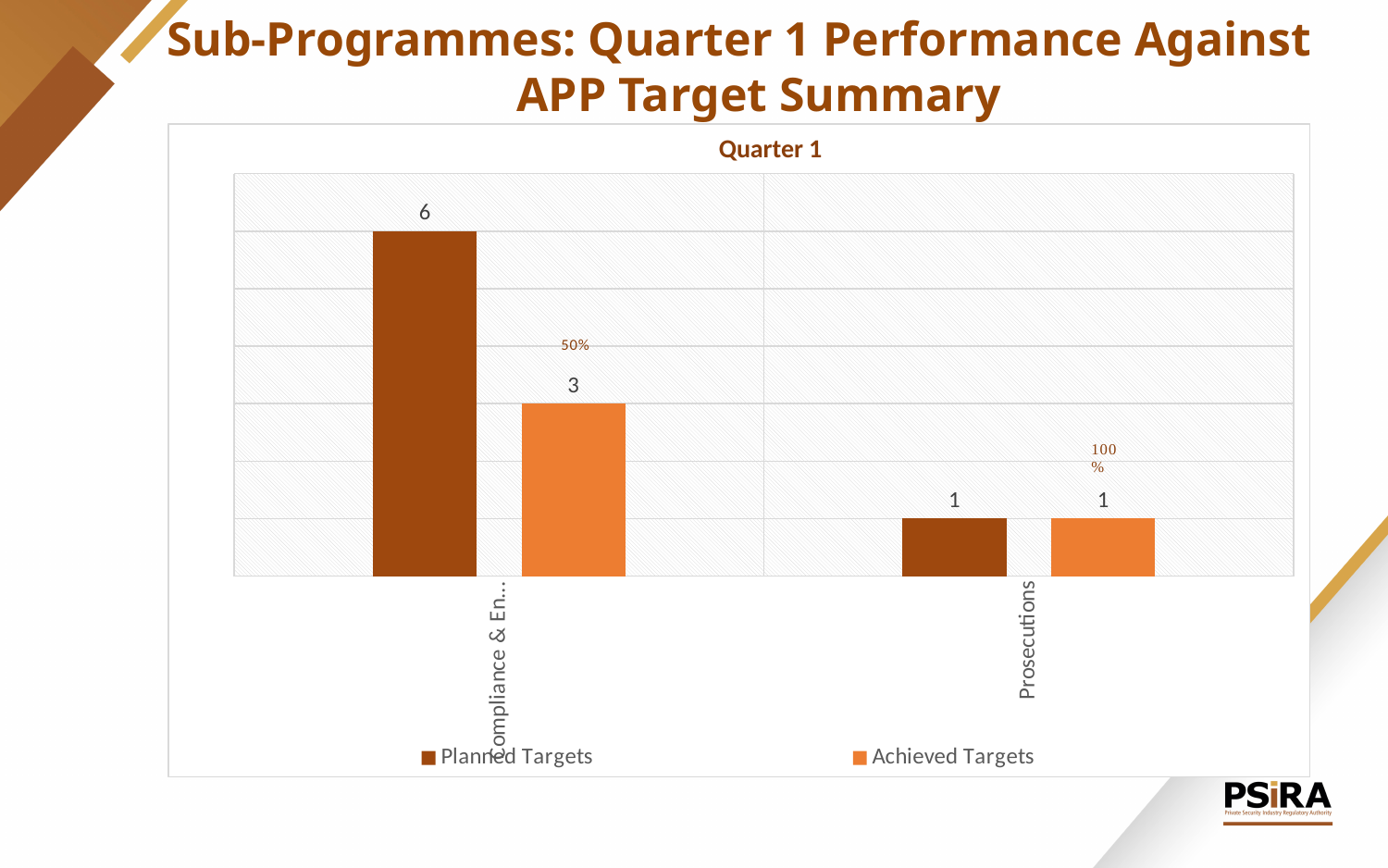
What type of chart is shown on the slide? Bar chart How many series does the legend list? 2 How many categories are shown on the x axis? 2 What percentage label is shown above the Achieved Targets bar for Prosecutions? 100% What is the Achieved Targets value for Compliance & En...? 3 What is the Planned Targets value for Compliance & En...? 6 Which category has the highest Planned Targets value? Compliance & En... What percentage label is shown above the Achieved Targets bar for Compliance & En...? 50% What is the difference between Planned Targets and Achieved Targets for Compliance & En...? 3 What is the Planned Targets value for Prosecutions? 1 Which is larger for Compliance & En..., Planned Targets or Achieved Targets? Planned Targets What is the Achieved Targets value for Prosecutions? 1